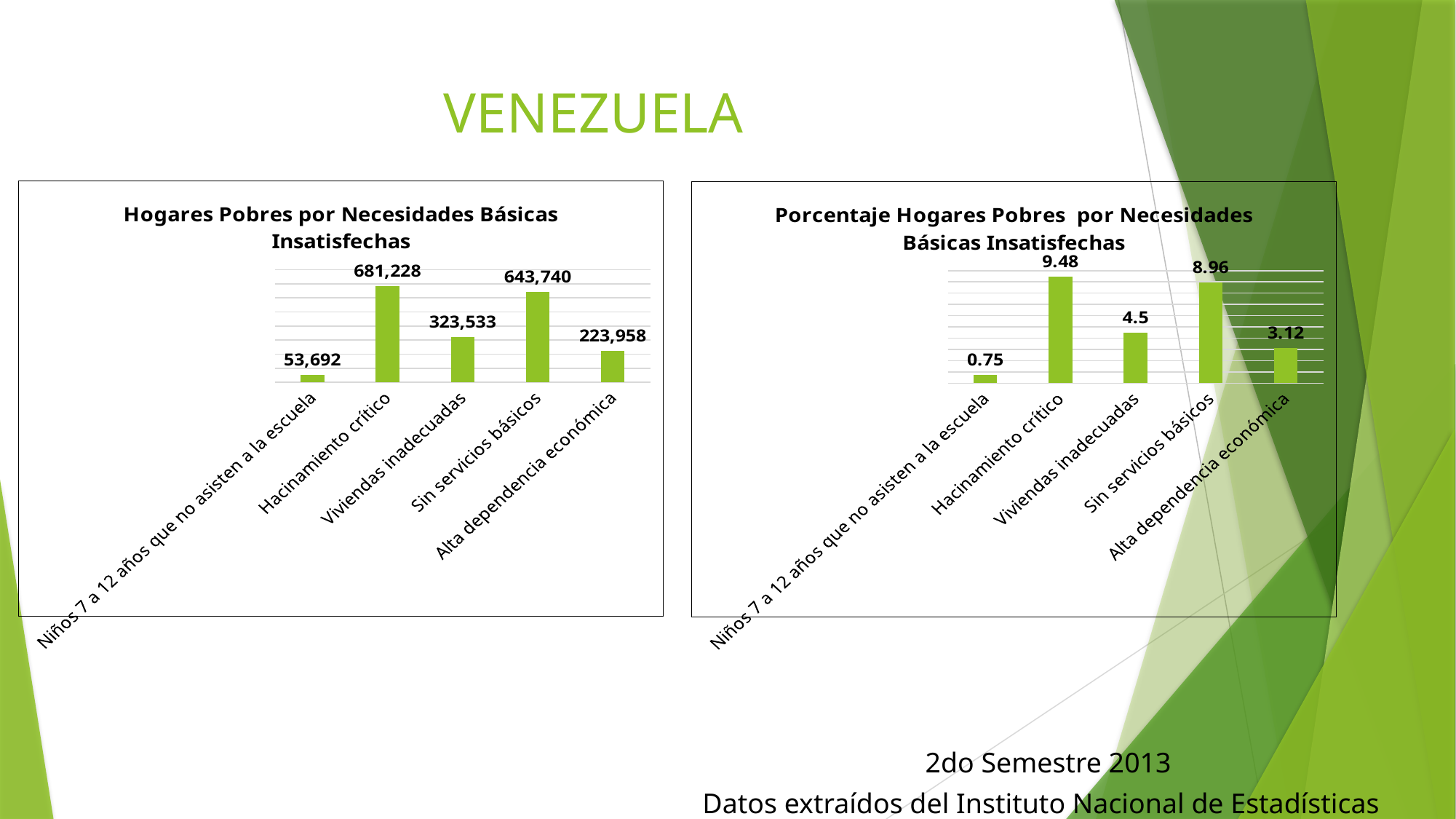
In the chart titled 'Hogares Pobres por Necesidades Básicas Insatisfechas', what is the value for Alta dependencia económica? 223,958 In the chart titled 'Porcentaje Hogares Pobres por Necesidades Básicas Insatisfechas', which category has the highest value? Hacinamiento crítico What type of chart is the chart on the right of the slide? Bar chart In the chart titled 'Porcentaje Hogares Pobres por Necesidades Básicas Insatisfechas', which is larger: Sin servicios básicos or Alta dependencia económica? Sin servicios básicos In the chart titled 'Porcentaje Hogares Pobres por Necesidades Básicas Insatisfechas', what is the difference between Hacinamiento crítico and Sin servicios básicos? 0.52 In the chart titled 'Porcentaje Hogares Pobres por Necesidades Básicas Insatisfechas', what is the value for Viviendas inadecuadas? 4.5 In the chart titled 'Hogares Pobres por Necesidades Básicas Insatisfechas', how many categories are shown? 5 In the chart titled 'Porcentaje Hogares Pobres por Necesidades Básicas Insatisfechas', what is the value for Niños 7 a 12 años que no asisten a la escuela? 0.75 In the chart titled 'Hogares Pobres por Necesidades Básicas Insatisfechas', what is the difference between Sin servicios básicos and Viviendas inadecuadas? 320,207 In the chart titled 'Hogares Pobres por Necesidades Básicas Insatisfechas', what is the value for Hacinamiento crítico? 681,228 In the chart titled 'Hogares Pobres por Necesidades Básicas Insatisfechas', which category has the lowest value? Niños 7 a 12 años que no asisten a la escuela In the chart titled 'Hogares Pobres por Necesidades Básicas Insatisfechas', which category has the highest value? Hacinamiento crítico